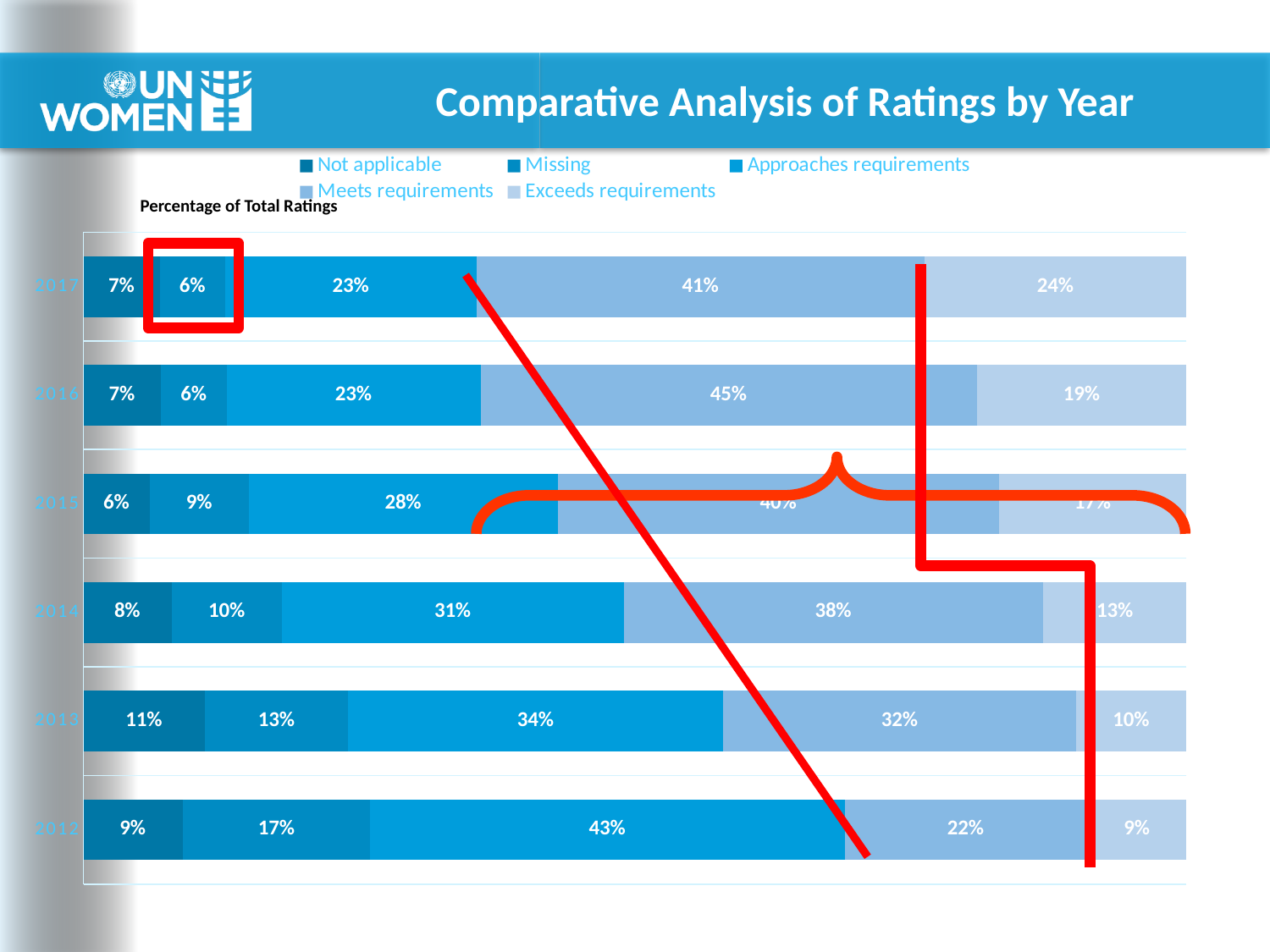
How many series does the legend list? 5 Which year has the highest Approaches requirements value? 2012 Which year has the larger Meets requirements value, 2014 or 2013? 2014 What is the title shown above the chart? Percentage of Total Ratings What is the Meets requirements value for 2017? 41% What is the difference between the Meets requirements values for 2016 and 2017? 4% What kind of chart is shown on the slide? bar chart What is the Not applicable value for 2013? 11% What is the Missing value for 2014? 10% What is the Approaches requirements value for 2012? 43% Which year has the highest Exceeds requirements value? 2017 How many years are shown on the chart? 6